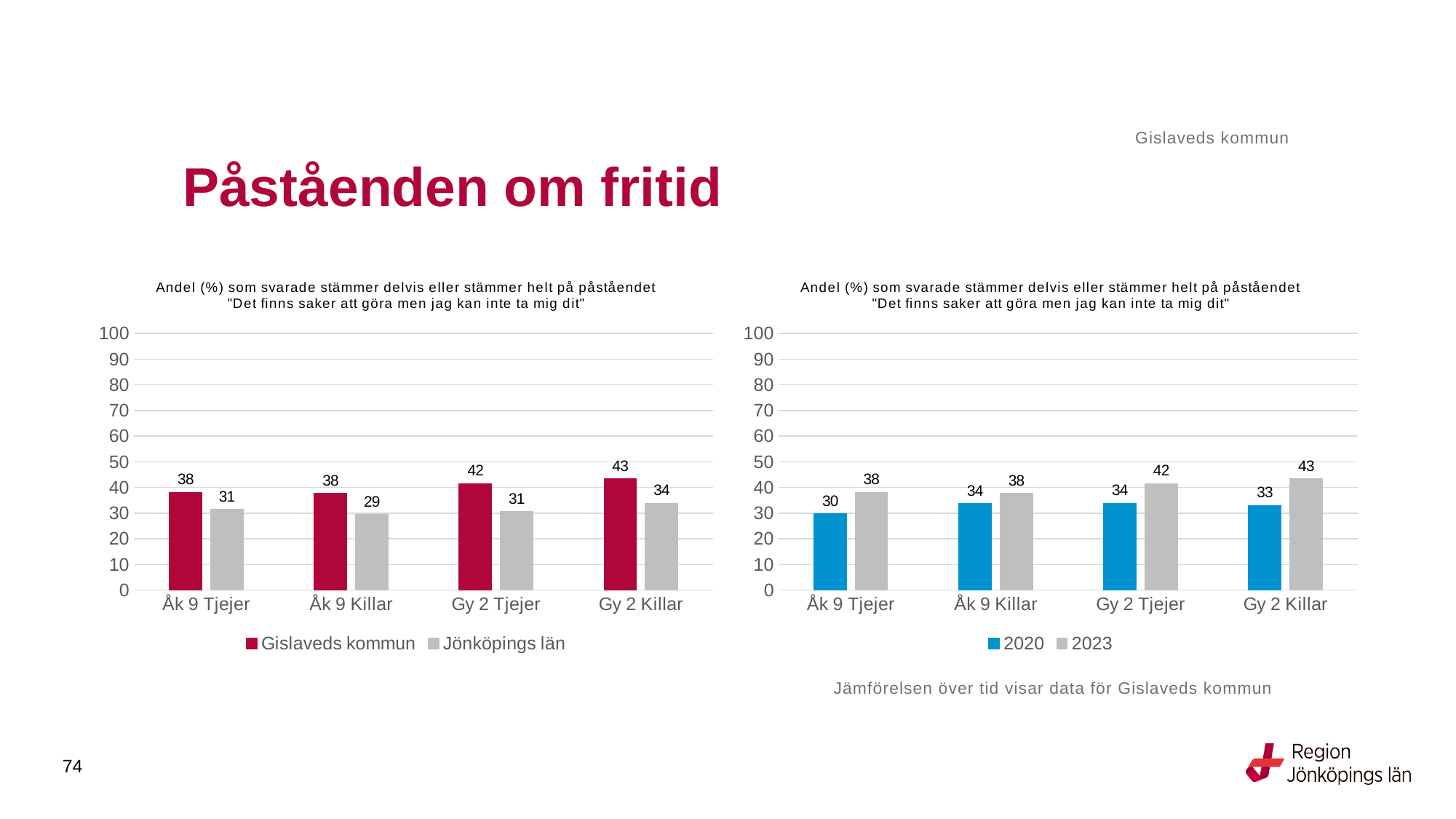
In the right chart, what is the difference between 2023 and 2020 for Gy 2 Killar? 10 In the left chart, which is larger for Åk 9 Tjejer: Gislaveds kommun or Jönköpings län? Gislaveds kommun In the right chart, what is the value for 2020 for Åk 9 Tjejer? 30 How many series does the legend of the right chart list? 2 In the left chart, what is the difference between Gislaveds kommun and Jönköpings län for Gy 2 Tjejer? 11 In the left chart, what is the value for Gislaveds kommun for Gy 2 Killar? 43 In the left chart, which category has the lowest value for Jönköpings län? Åk 9 Killar In the left chart, which category has the highest value for Gislaveds kommun? Gy 2 Killar In the right chart, what is the value for 2023 for Gy 2 Tjejer? 42 What kind of chart is the left chart? Bar chart In the left chart, what is the value for Jönköpings län for Åk 9 Killar? 29 In the right chart, which category has the lowest value for 2020? Åk 9 Tjejer